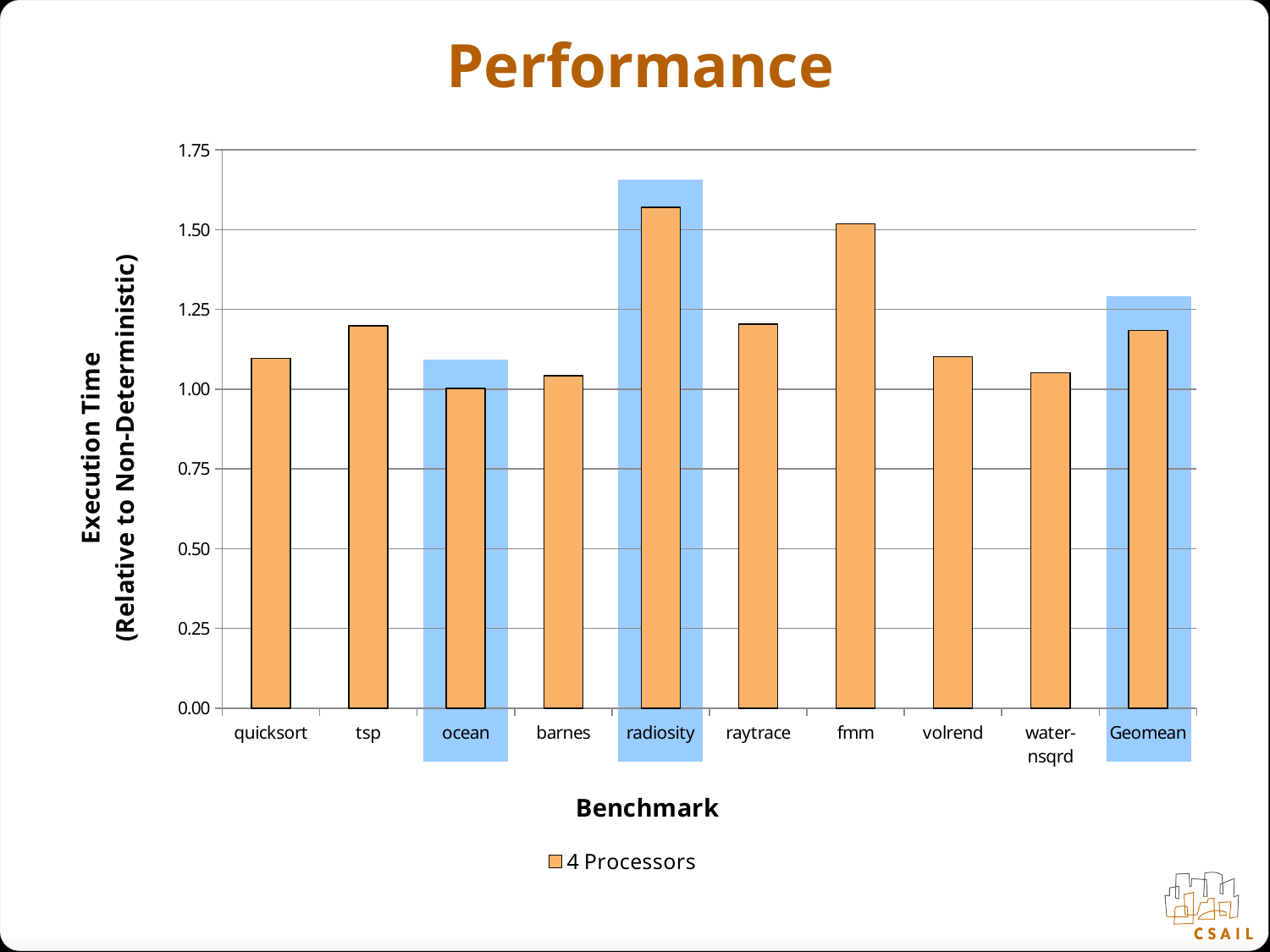
How many series does the legend list? 1 Is the value for radiosity greater or less than 1.50? greater Is the value for tsp greater or less than 1.25? less Which has the larger relative execution time, fmm or quicksort? fmm How many benchmarks are plotted along the x axis? 10 Is the value for quicksort greater or less than 1.00? greater Which benchmark has the highest relative execution time? radiosity What series name is shown in the legend? 4 Processors Which benchmark has the lowest relative execution time? ocean What kind of chart is shown on the slide? bar chart Which has the larger relative execution time, tsp or barnes? tsp